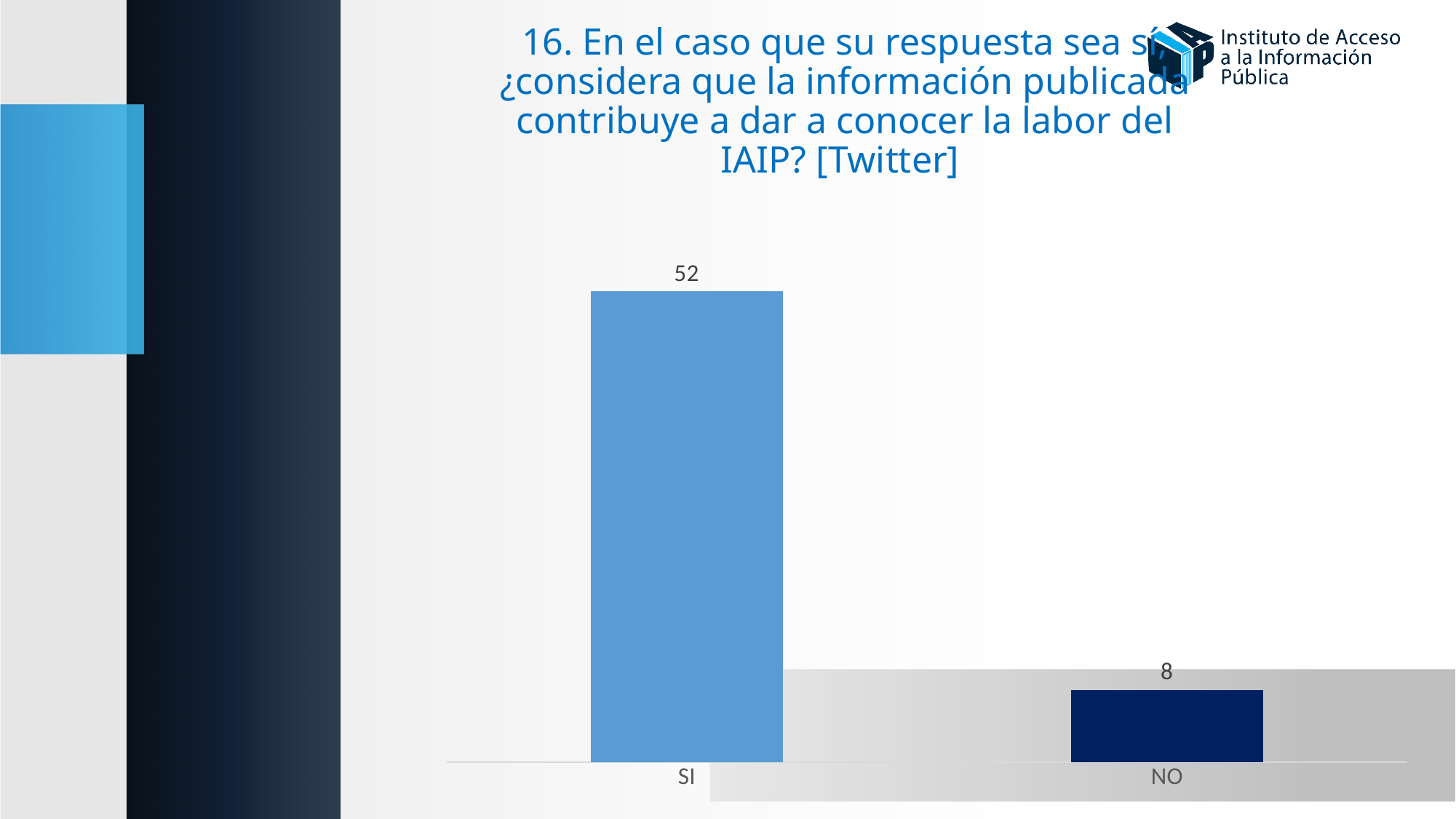
How many categories are shown in the chart? 2 What colour is the bar for NO? Dark navy blue What is the value for NO? 8 What is the value for SI? 52 What social network is named in brackets in the chart title? Twitter What is the total of the values for SI and NO? 60 What kind of chart is shown on the slide? Bar chart Which category has the highest value? SI What is the difference between the values for SI and NO? 44 Which is larger, the value for SI or the value for NO? SI Which category has the lowest value? NO